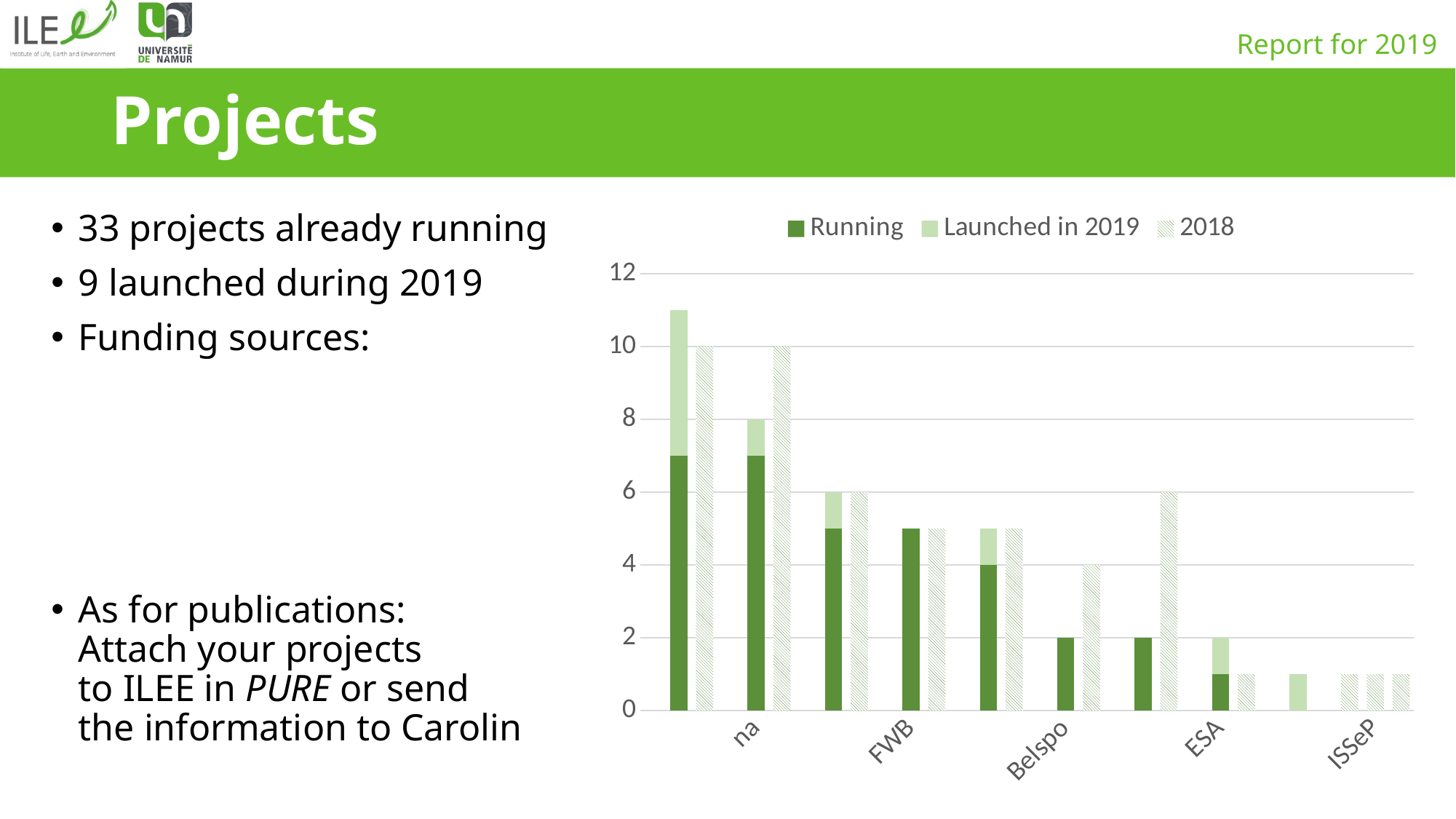
What is the 2018 value for the category na? 10 What kind of chart is shown on the slide? bar chart What is the total height of the stacked bar (Running plus Launched in 2019) for ESA? 2 Which has the larger 2018 value, na or FWB? na What is the Running value for Belspo? 2 What are the three series named in the chart legend? Running, Launched in 2019, 2018 Do the bar heights generally rise or fall moving from left to right along the x axis? fall Is the Running value for FWB greater or less than 4? greater How many series does the chart legend list? 3 Among the labelled categories, which has the highest 2018 value? na Is the Running value for na greater or less than 6? greater Is the 2018 value for ISSeP greater or less than 2? less